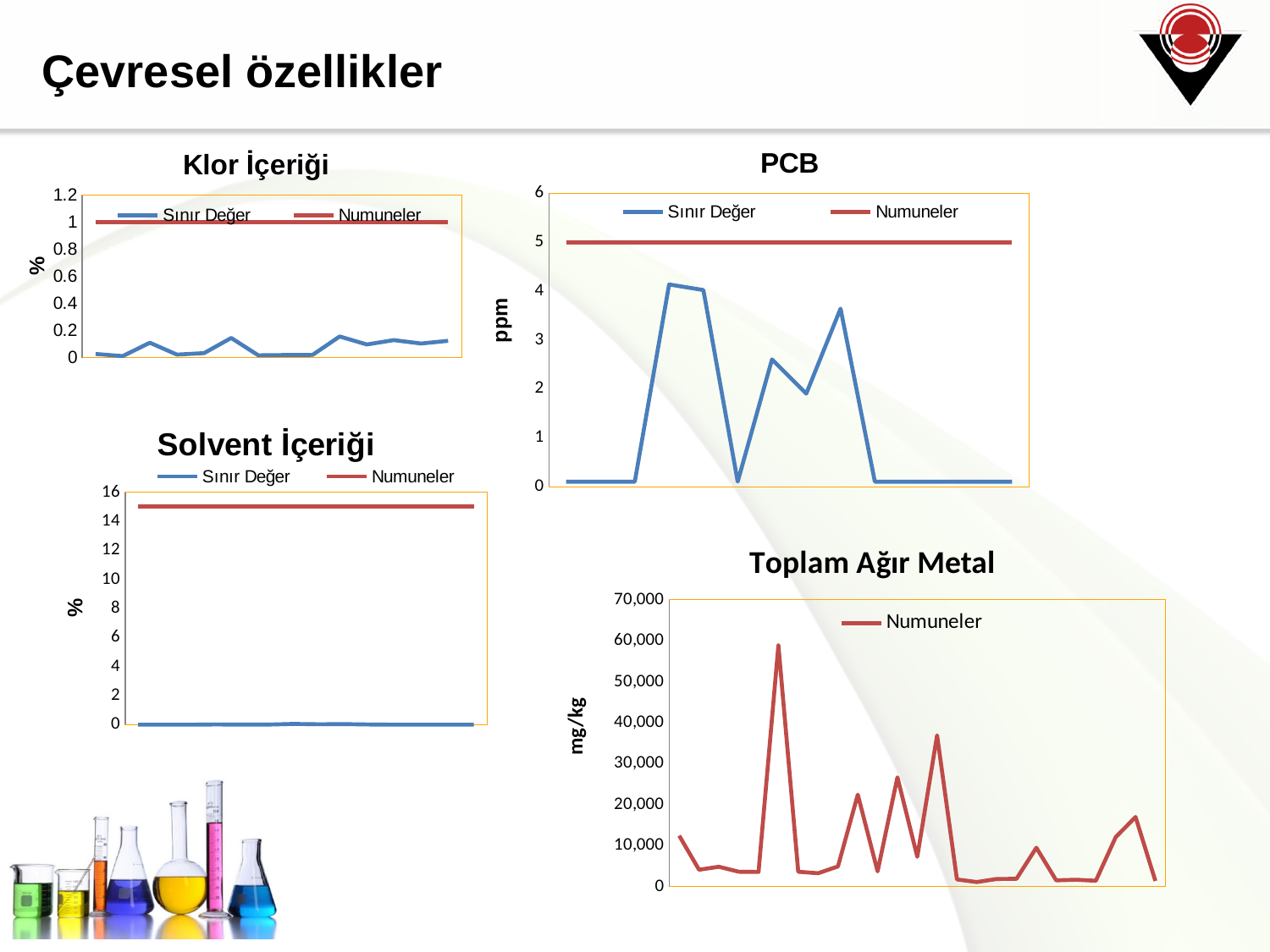
What kind of chart is the "Toplam Ağır Metal" chart? line chart How many series does the legend of the "Klor İçeriği" chart list? 2 What is the y-axis label of the "Toplam Ağır Metal" chart? mg/kg In the "Solvent İçeriği" chart, is the red Numuneler line greater or less than 14? greater What is the y-axis label of the "PCB" chart? ppm How many series does the legend of the "Toplam Ağır Metal" chart list? 1 In the "Solvent İçeriği" chart, is the blue Sınır Değer line greater or less than 2? less In the "Toplam Ağır Metal" chart, is the highest peak of the Numuneler line greater or less than 50,000? greater What kind of chart is the "PCB" chart? line chart